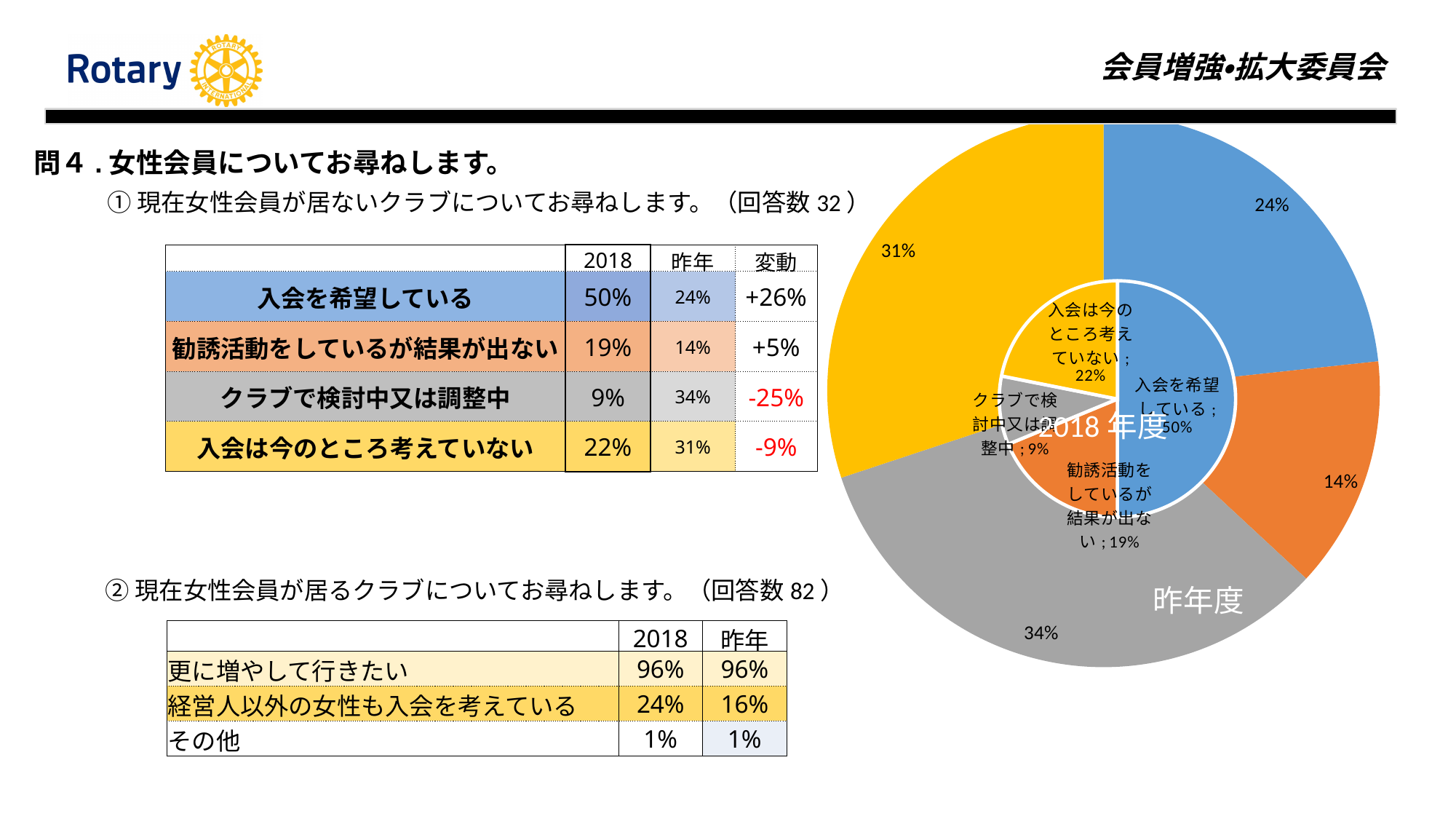
What kind of chart is shown on the right side of the slide? Pie chart In the pie chart, what is the 2018年度 share for 勧誘活動をしているが結果が出ない? 19% In the pie chart, which category has the smallest 2018年度 share? クラブで検討中又は調整中 In the pie chart, what is the 2018年度 share for 入会を希望している? 50% In the pie chart, what is the difference between the 2018年度 share for 入会を希望している (50%) and the 2018年度 share for 入会は今のところ考えていない (22%)? 28% In the pie chart, what is the 2018年度 share for 入会は今のところ考えていない? 22% In the pie chart, how many categories are shown in the inner 2018年度 pie? 4 In the pie chart, what is the 2018年度 share for クラブで検討中又は調整中? 9% In the pie chart, which category has the largest 2018年度 share? 入会を希望している In the pie chart, which two periods are labelled on the chart? 2018 年度 and 昨年度 In the pie chart, what is the largest percentage shown on the outer 昨年度 ring? 34% In the pie chart, what is the smallest percentage shown on the outer 昨年度 ring? 14%